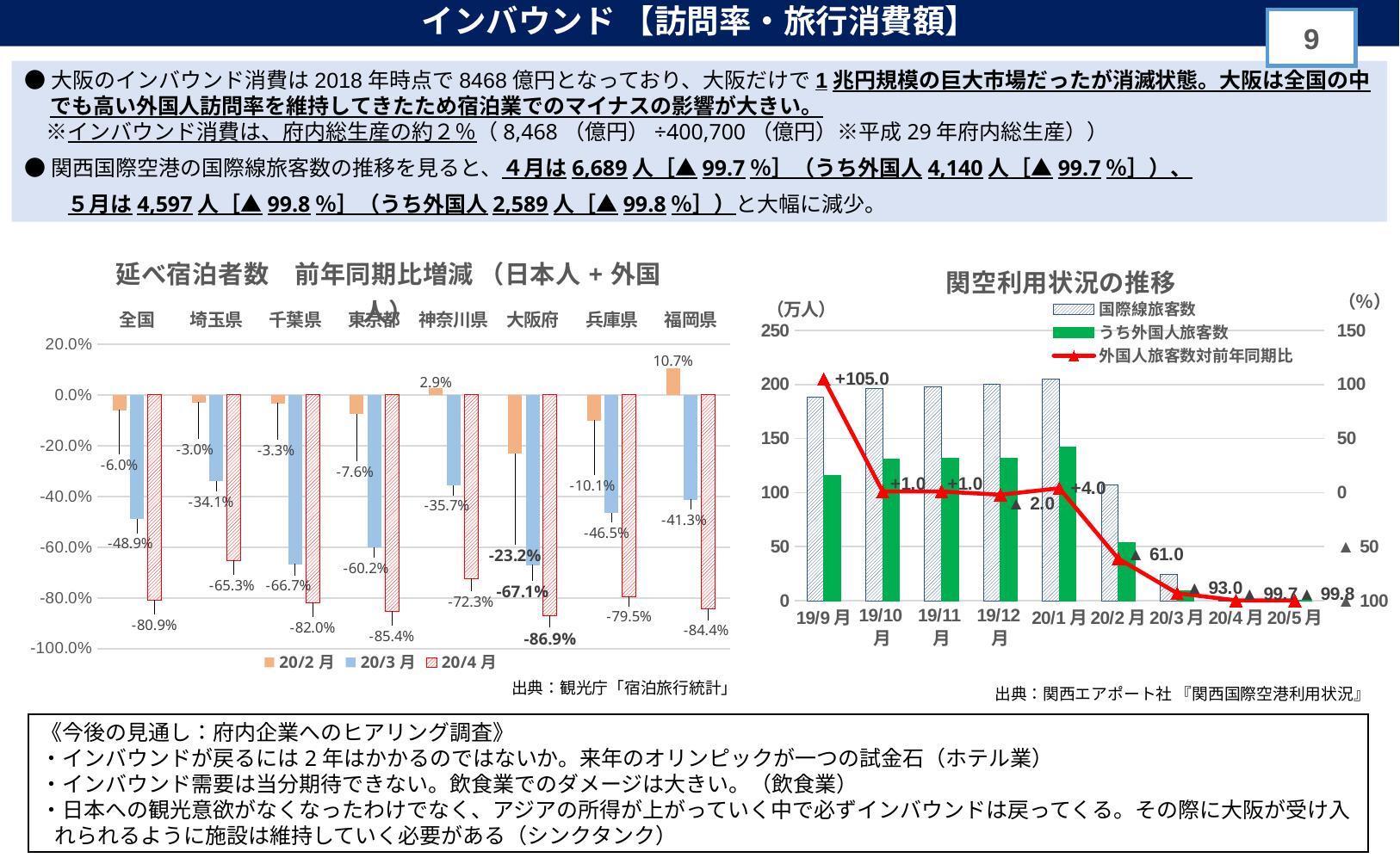
In the right chart (関空利用状況の推移), what is the value of 外国人旅客数対前年同期比 for 19/9月? +105.0 In the left chart (延べ宿泊者数 前年同期比増減), which category has the highest value in the 20/2月 series? 福岡県 In the right chart (関空利用状況の推移), what is the value of 外国人旅客数対前年同期比 for 20/5月? ▲99.8 In the left chart (延べ宿泊者数 前年同期比増減), what is the difference between the 20/3月 values for 大阪府 (-67.1%) and 全国 (-48.9%)? 18.2 percentage points In the left chart (延べ宿泊者数 前年同期比増減), what is the value for 福岡県 in the 20/2月 series? 10.7% In the left chart (延べ宿泊者数 前年同期比増減), which prefecture has the lowest value in the 20/4月 series? 大阪府 In the left chart (延べ宿泊者数 前年同期比増減), what is the value for 大阪府 in the 20/4月 series? -86.9% How many series does the legend of the left chart (延べ宿泊者数 前年同期比増減) list? 3 In the right chart (関空利用状況の推移), does the 外国人旅客数対前年同期比 line rise or fall from 20/1月 to 20/5月? fall In the left chart (延べ宿泊者数 前年同期比増減), what is the value for 全国 in the 20/3月 series? -48.9% In the left chart (延べ宿泊者数 前年同期比増減), which is larger in the 20/3月 series: 埼玉県 or 千葉県? 埼玉県 How many categories are shown on the x axis of the left chart (延べ宿泊者数 前年同期比増減)? 8